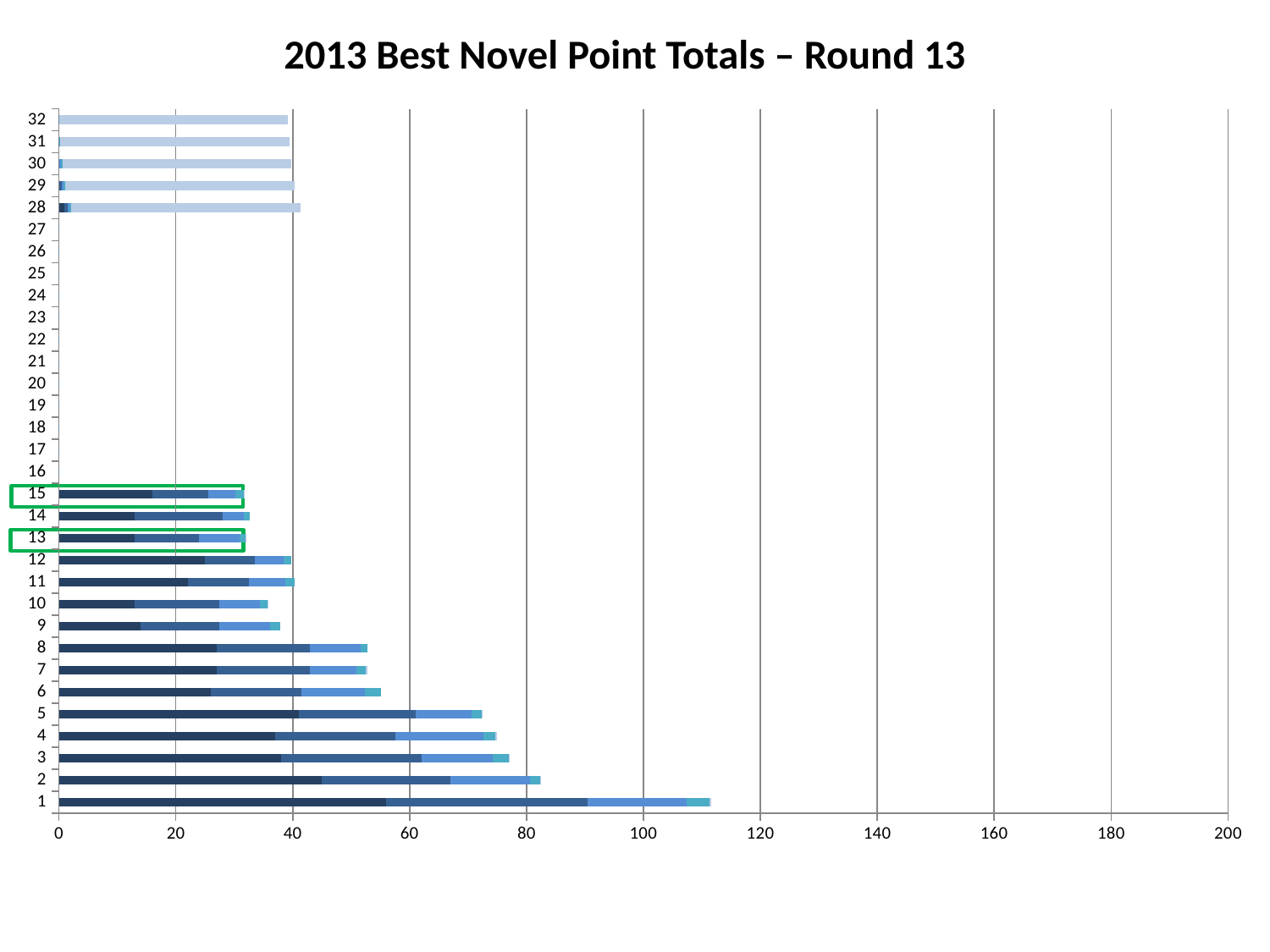
Which has the larger total, category 8 or category 10? 8 How many categories are listed on the vertical axis of the chart? 32 Do the bar lengths generally increase or decrease going from category 1 up to category 15? decrease Is the total value for category 8 greater or less than 40? greater Which two categories are highlighted with green boxes on the chart? 13 and 15 Which has the larger total, category 1 or category 2? 1 What kind of chart is shown on the slide? Stacked horizontal bar chart Which category has the longest bar in the chart? 1 Is the total value for category 1 greater or less than 100? greater What is the title of the chart? 2013 Best Novel Point Totals – Round 13 Is the total value for category 6 greater or less than 60? less